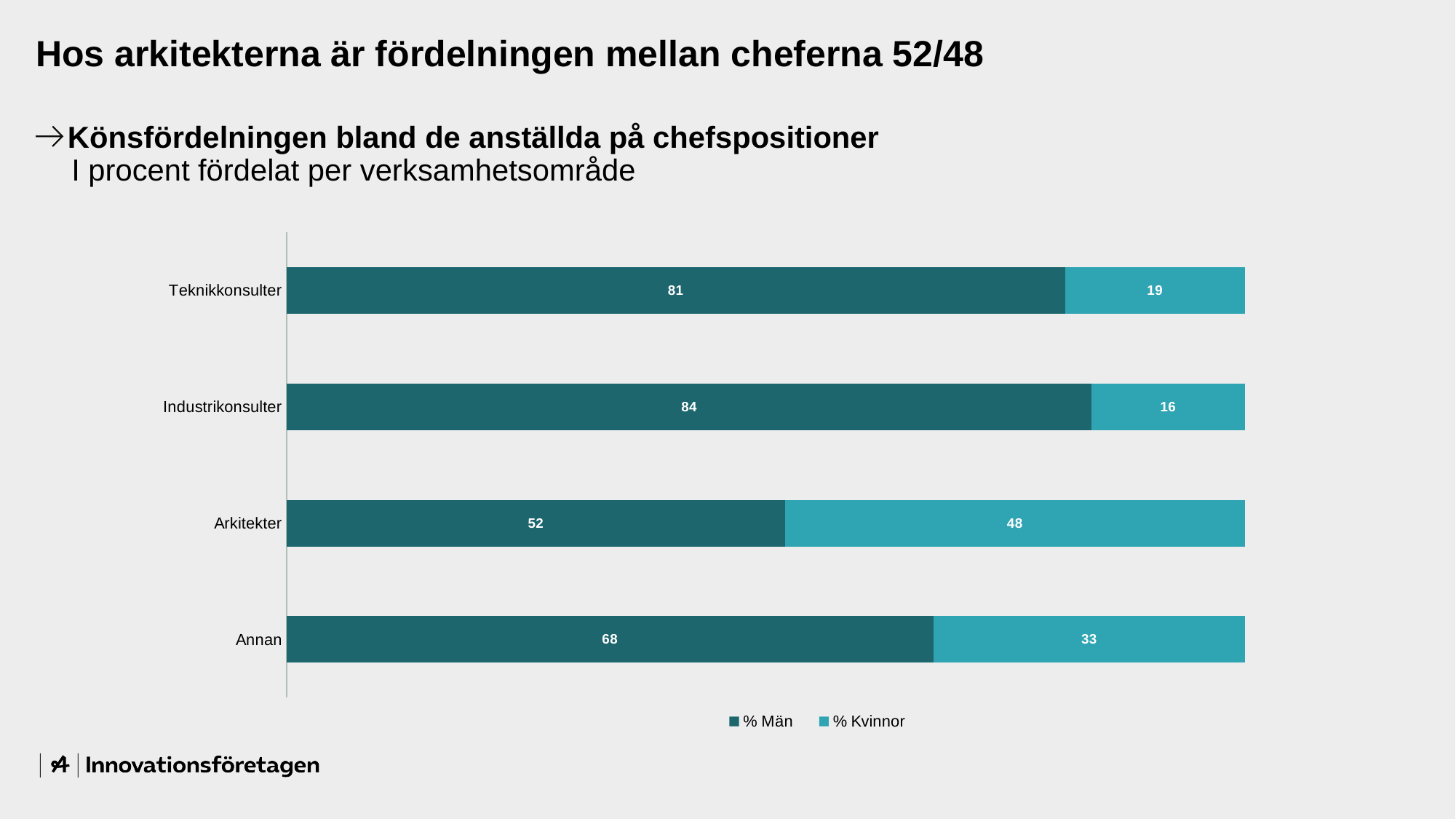
What kind of chart is shown on the slide? Stacked bar chart How many categories are shown on the chart? 4 Which category has the highest % Män value? Industrikonsulter What is the % Män value for Teknikkonsulter? 81 What is the % Kvinnor value for Industrikonsulter? 16 What is the % Kvinnor value for Arkitekter? 48 How many series does the legend list? 2 What is the total of the stacked bar for Annan? 101 What is the difference between the % Män and % Kvinnor values for Annan? 35 Which category has the lowest % Kvinnor value? Industrikonsulter Which is larger: the % Kvinnor value for Teknikkonsulter or for Annan? Annan What is the % Män value for Annan? 68